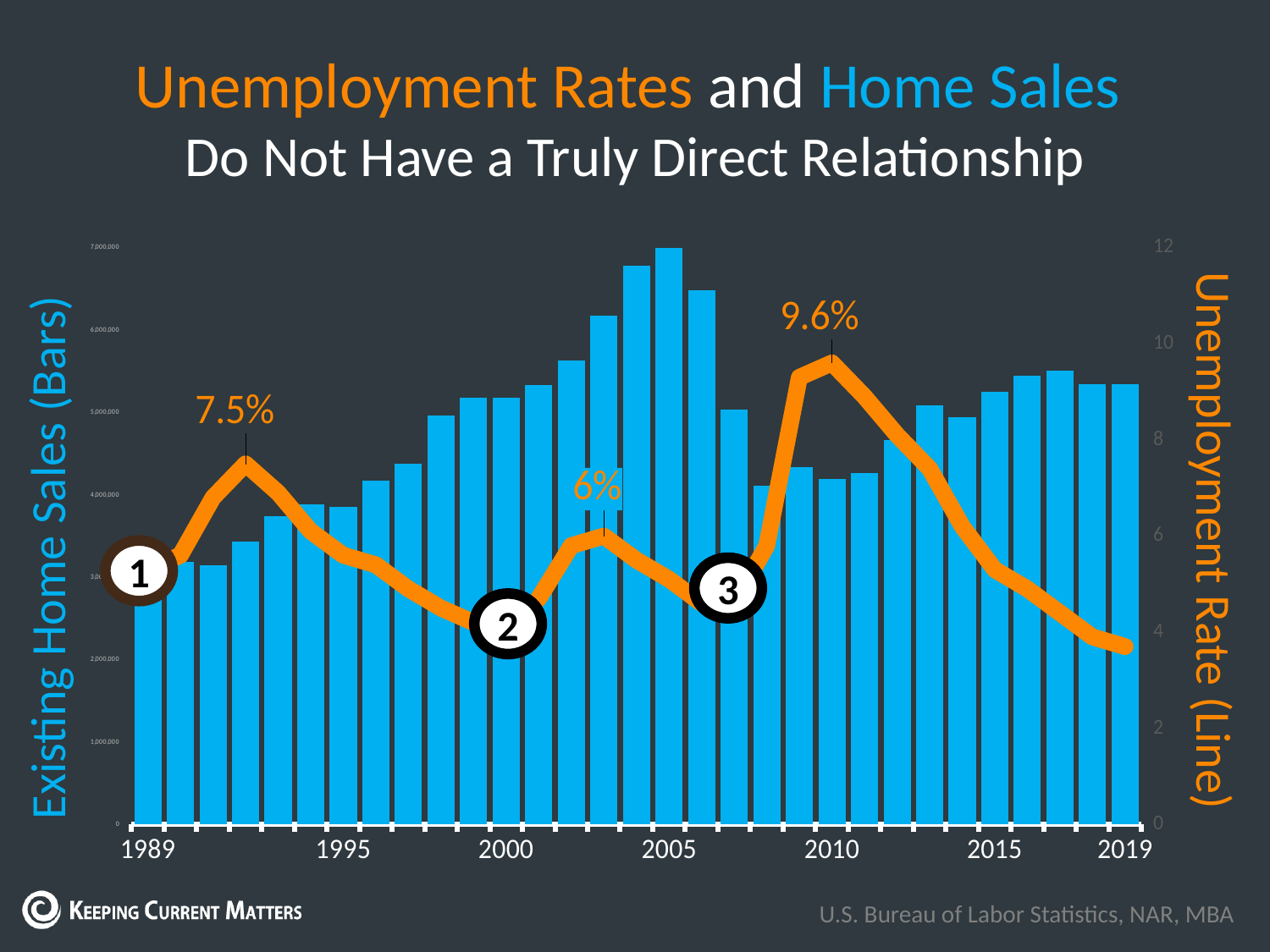
What is the difference between the labeled unemployment rates of 9.6% and 7.5%? 2.1% What unemployment rate is labeled on the line around 1992? 7.5% What is the labeled peak unemployment rate around 2010? 9.6% Is the existing home sales value for 2010 greater or less than 5,000,000? less Is the existing home sales value for 2005 greater or less than 6,000,000? greater Which labeled unemployment rate is higher, the one around 1992 or the one around 2010? The one around 2010 (9.6%) What does the right-hand axis of the chart represent? Unemployment Rate (Line) Do existing home sales rise or fall from 2000 to 2005? Rise What kind of chart is shown on the slide? A combination bar and line chart Is the existing home sales value for 1990 greater or less than 4,000,000? less In which year is the existing home sales bar the tallest? 2005 What unemployment rate is labeled on the line around 2003? 6%